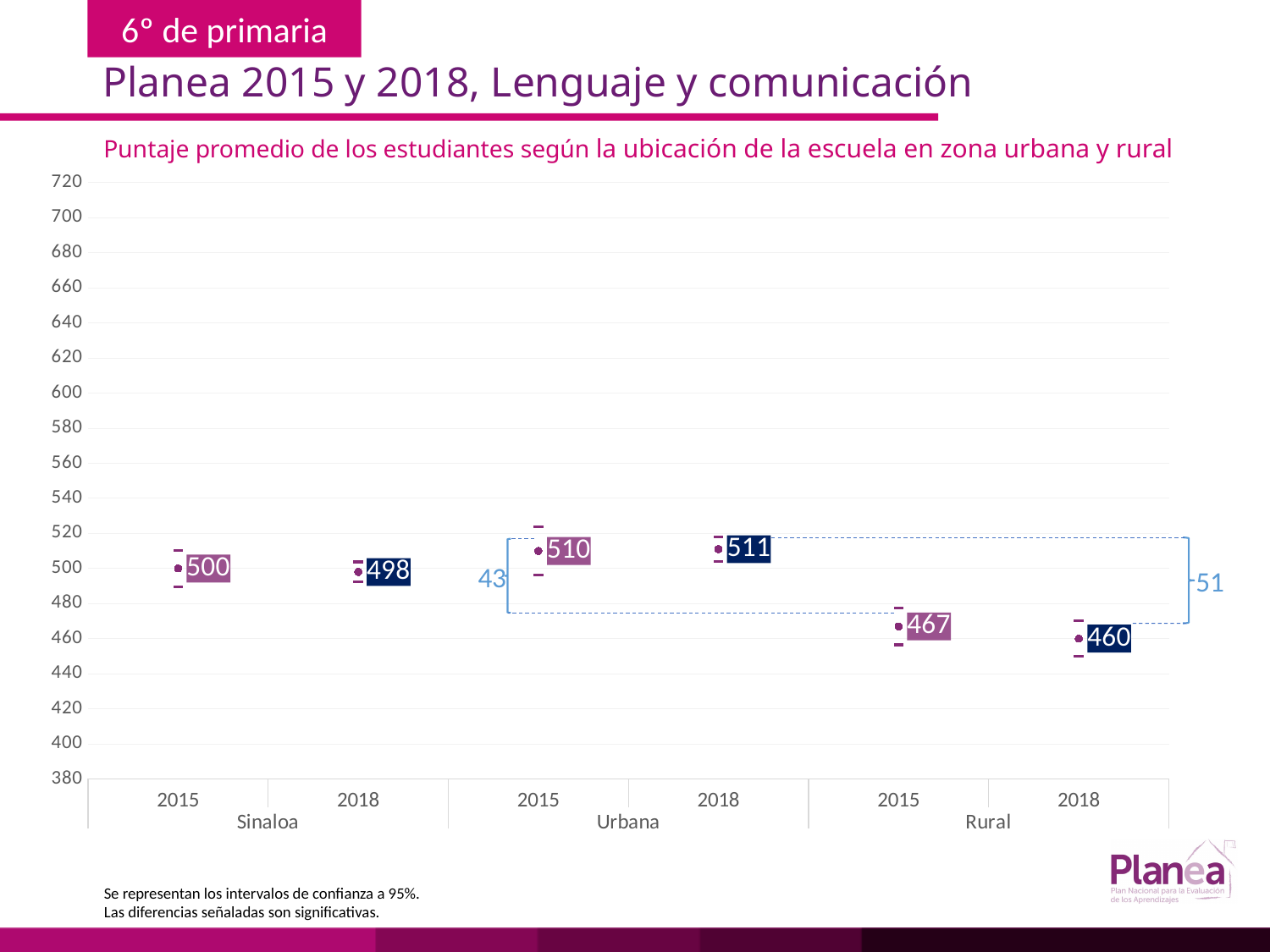
What is the difference between the Urbana 2015 score and the Rural 2015 score? 43 Which is larger, the Rural 2015 score or the Rural 2018 score? Rural 2015 What is the subtitle of the chart? Puntaje promedio de los estudiantes según la ubicación de la escuela en zona urbana y rural What is the average score for Sinaloa in 2015? 500 Did the Rural average score rise or fall from 2015 to 2018? Fall How many data points are plotted on the chart? 6 What is the difference between the Urbana 2018 score and the Rural 2018 score? 51 What is the average score for Rural schools in 2015? 467 Which group and year has the highest average score? Urbana 2018 Which group and year has the lowest average score? Rural 2018 What is the average score for Urbana schools in 2018? 511 What is the average score for Sinaloa in 2018? 498